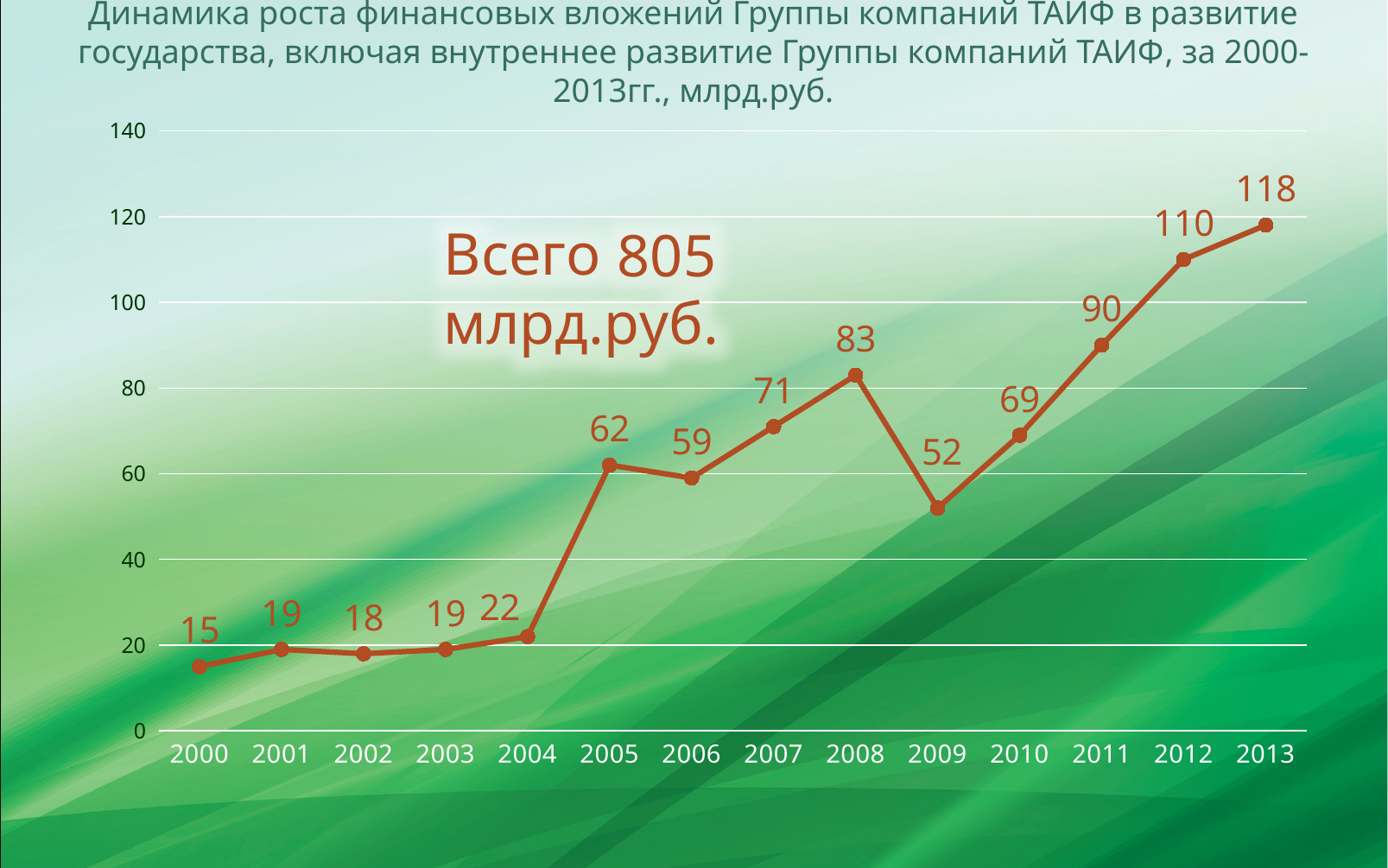
Which is larger, the value for 2005 or the value for 2006? 2005 What is the difference between the values for 2008 and 2009? 31 What kind of chart is this? line chart Which year has the lowest value? 2000 What is the value for 2008? 83 What total is stated in the text on the chart? Всего 805 млрд.руб. Which year has the highest value? 2013 Is the value for 2011 greater or less than 80? greater What is the value for 2009? 52 How many years are plotted on the x axis? 14 What is the difference between the values for 2013 and 2012? 8 What is the value for 2000? 15